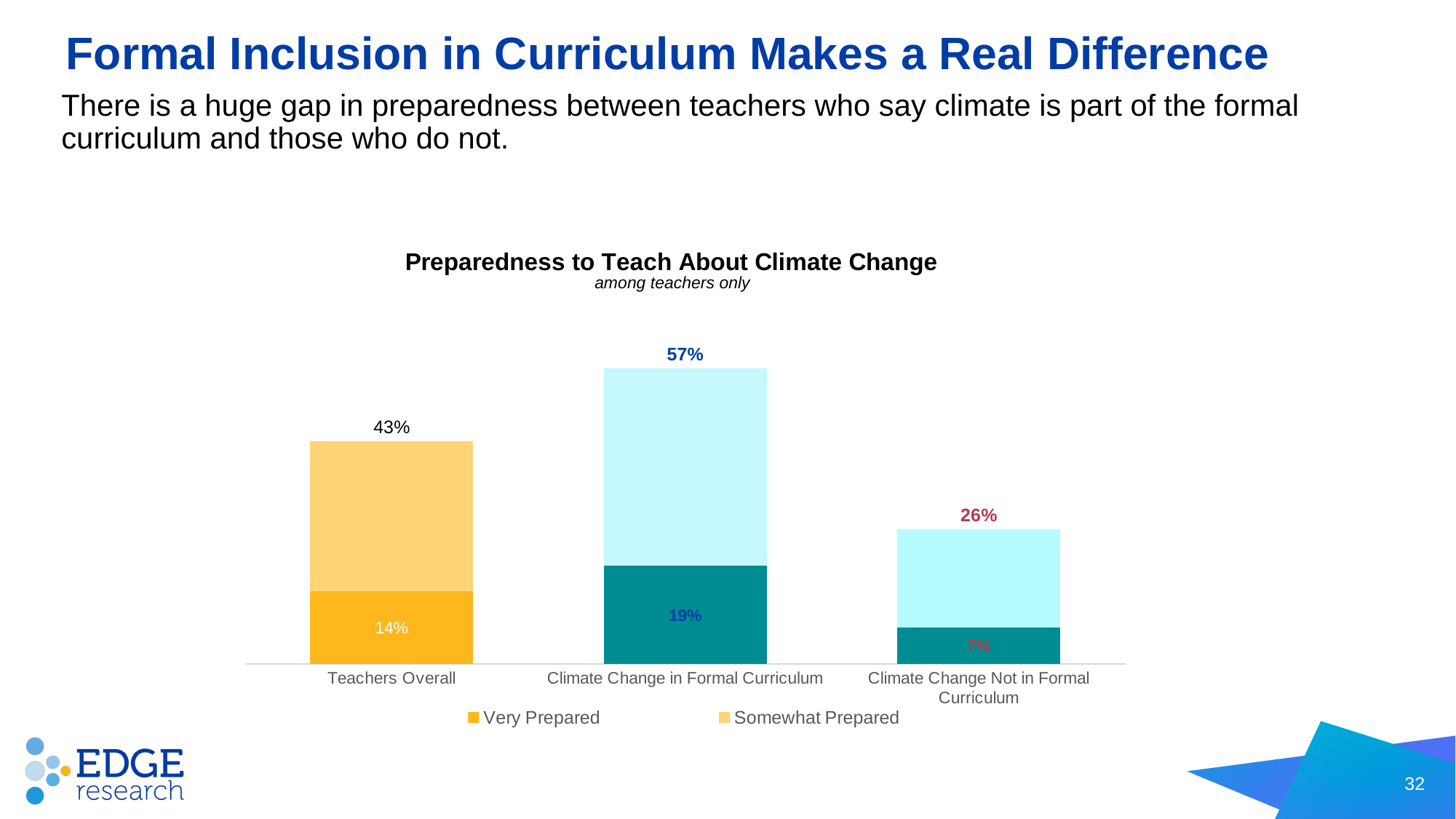
Which category has the lowest Very Prepared value? Climate Change Not in Formal Curriculum What is the total percentage shown above the bar for Teachers Overall? 43% What is the Very Prepared value for Climate Change Not in Formal Curriculum? 7% What is the difference between the total for Climate Change in Formal Curriculum and the total for Climate Change Not in Formal Curriculum? 31 percentage points How many series does the legend list? 2 Which is larger: the Very Prepared value for Climate Change in Formal Curriculum or for Teachers Overall? Climate Change in Formal Curriculum What is the total percentage shown above the bar for Climate Change in Formal Curriculum? 57% Which category has the highest total bar? Climate Change in Formal Curriculum How many categories are shown on the x axis? 3 What is the title of the chart? Preparedness to Teach About Climate Change What kind of chart is shown on the slide? Stacked bar chart What is the Very Prepared value for Teachers Overall? 14%